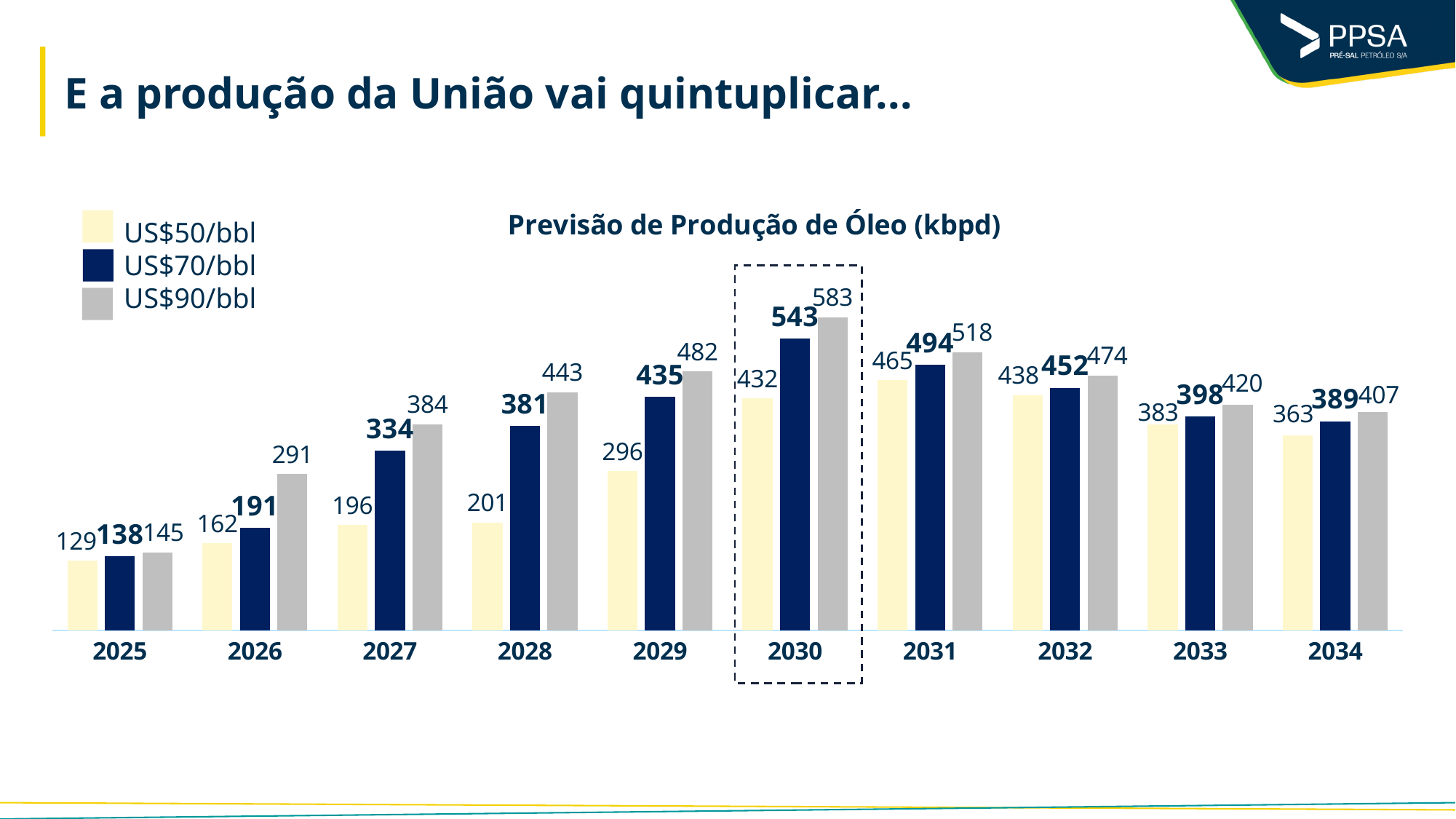
What is the difference between the US$70/bbl values in 2026 and 2025? 53 How many years are shown on the x axis? 10 What kind of chart is shown on the slide? Bar chart Which year has the highest value for the US$90/bbl series? 2030 What is the title of the chart? Previsão de Produção de Óleo (kbpd) How many series does the legend list? 3 What is the value for US$70/bbl in 2030? 543 What is the difference between the US$90/bbl and US$50/bbl values in 2030? 151 What is the value for US$90/bbl in 2034? 407 Which is larger: the US$70/bbl value in 2031 or the US$90/bbl value in 2032? US$70/bbl in 2031 Which year has the lowest value for the US$50/bbl series? 2025 What is the value for US$50/bbl in 2027? 196